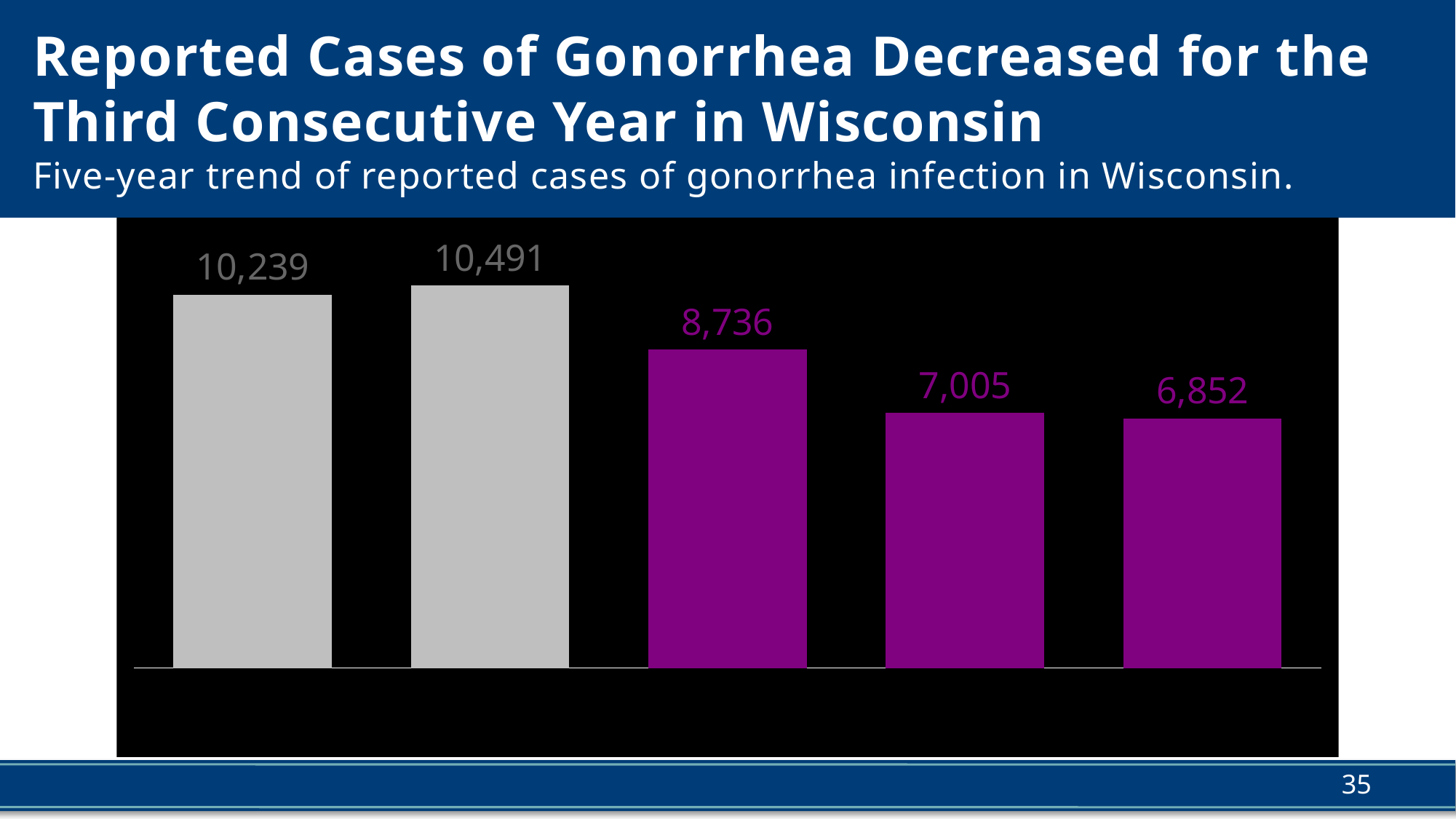
What is the value shown on the first (leftmost) bar? 10,239 Do the values rise or fall from the second bar to the last bar? fall What colour are the last three bars in the chart? purple What is the highest value shown in the chart? 10,491 Which is larger, the value of the first bar or the value of the second bar? the second bar What is the value shown on the fourth bar from the left? 7,005 What is the lowest value shown in the chart? 6,852 What is the difference between the third bar (8,736) and the fourth bar (7,005)? 1,731 What is the value shown on the third bar from the left? 8,736 What is the difference between the second bar (10,491) and the first bar (10,239)? 252 What kind of chart is shown on the slide? bar chart How many bars are plotted in the chart? 5